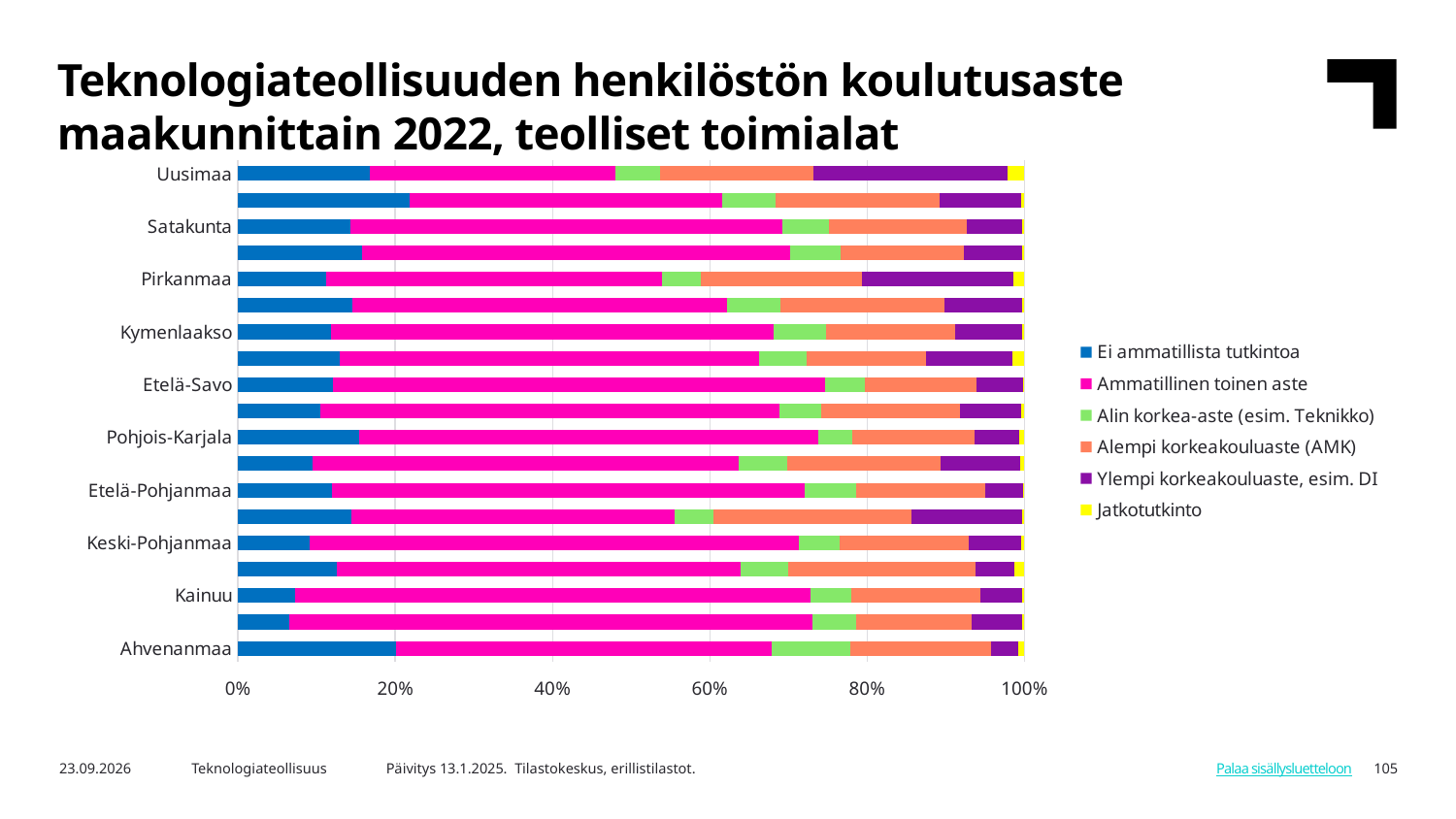
What does each stacked bar total on the x axis? 100% Is the Ei ammatillista tutkintoa share for Uusimaa greater or less than 20%? less How many series does the legend list? 6 Among the labelled regions, which has the largest Ylempi korkeakouluaste, esim. DI share? Uusimaa Which legend entry is shown in yellow? Jatkotutkinto Which has the larger Ammatillinen toinen aste share, Kainuu or Uusimaa? Kainuu Is the Ammatillinen toinen aste share for Uusimaa greater or less than 40%? less Which has the larger Ylempi korkeakouluaste, esim. DI share, Uusimaa or Kainuu? Uusimaa Is the Ei ammatillista tutkintoa share for Kainuu greater or less than 20%? less What kind of chart is shown on the slide? Stacked bar chart What is the title of the chart? Teknologiateollisuuden henkilöstön koulutusaste maakunnittain 2022, teolliset toimialat